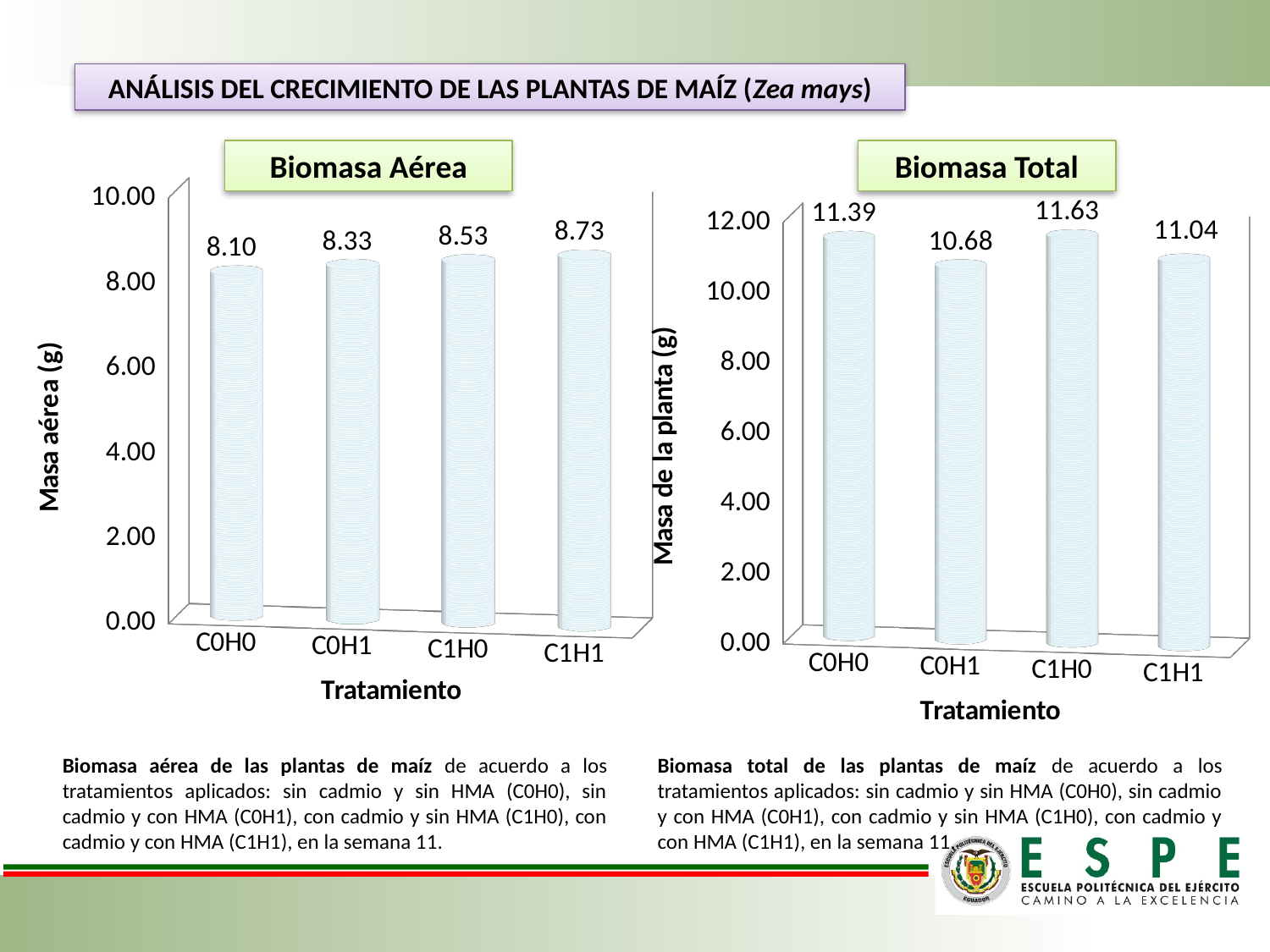
In the Biomasa Aérea chart, which treatment has the highest value? C1H1 In the Biomasa Total chart, what is the value for C1H0? 11.63 What kind of chart is the Biomasa Aérea chart? bar chart In the Biomasa Aérea chart, what is the value for C1H1? 8.73 In the Biomasa Aérea chart, what is the difference between the values for C1H1 and C0H0? 0.63 In the Biomasa Total chart, which treatment has the lowest value? C0H1 In the Biomasa Total chart, what is the difference between the values for C1H0 and C0H1? 0.95 In the Biomasa Total chart, which is larger, the value for C0H0 or the value for C1H1? C0H0 How many treatments are shown in the Biomasa Total chart? 4 In the Biomasa Aérea chart, what is the value for C0H0? 8.10 In the Biomasa Total chart, what is the value for C0H1? 10.68 In the Biomasa Aérea chart, do the values rise or fall from C0H0 to C1H1? rise